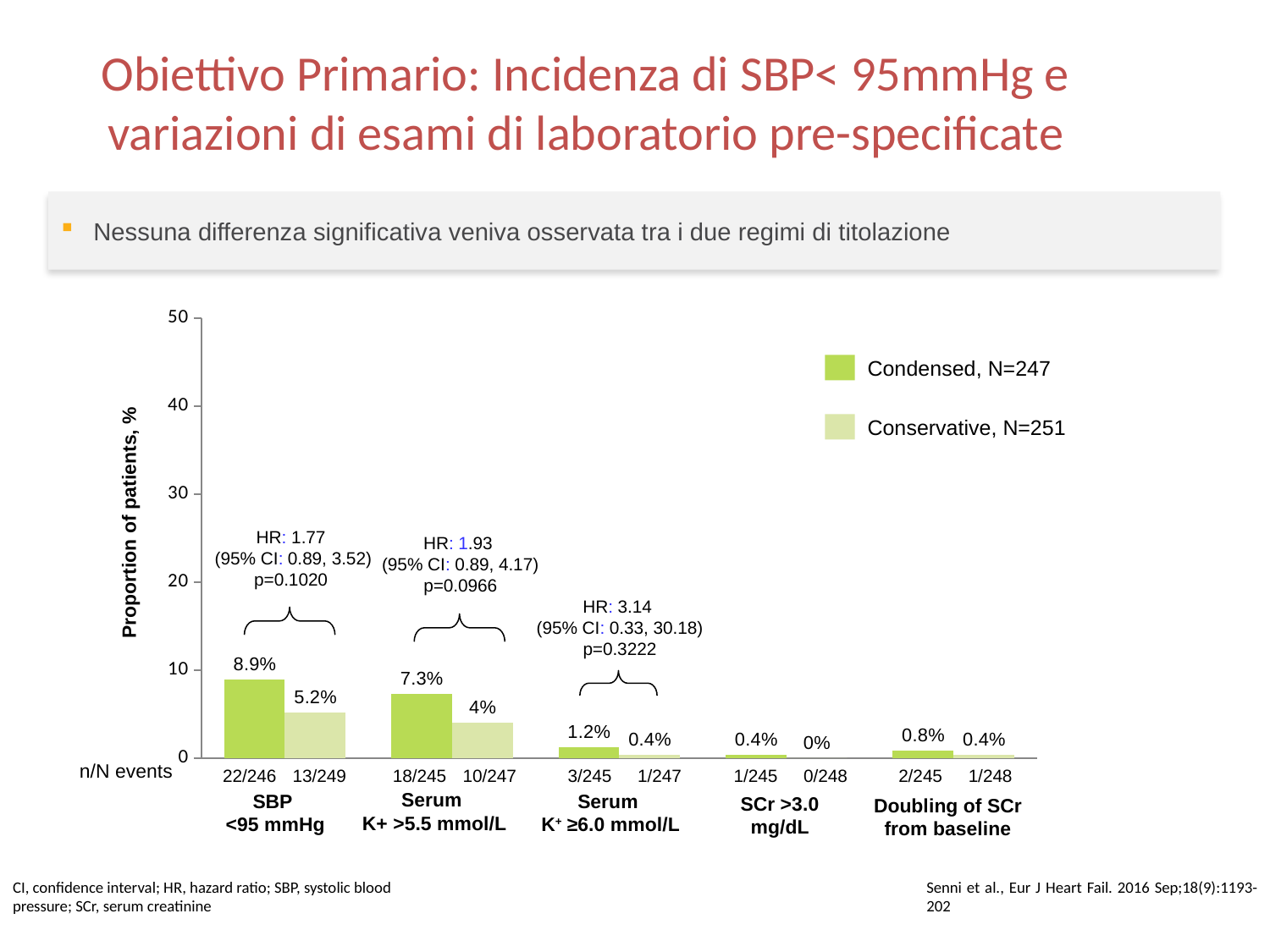
What is the proportion of patients with Doubling of SCr from baseline in the Condensed group? 0.8% What kind of chart is shown on the slide? bar chart What is the proportion of patients with SCr >3.0 mg/dL in the Conservative group? 0% Which group has the larger proportion of patients with Serum K+ >5.5 mmol/L, Condensed or Conservative? Condensed What is the hazard ratio shown for Serum K+ ≥6.0 mmol/L? 3.14 Which category has the highest proportion of patients in the Condensed group? SBP <95 mmHg Is the Condensed value for SBP <95 mmHg greater or less than 10? less How many series does the legend list? 2 How many categories are shown on the x axis? 5 What is the difference between the Condensed and Conservative proportions for SBP <95 mmHg? 3.7% What is the proportion of patients with Serum K+ >5.5 mmol/L in the Conservative group? 4% What is the proportion of patients with SBP <95 mmHg in the Condensed group? 8.9%